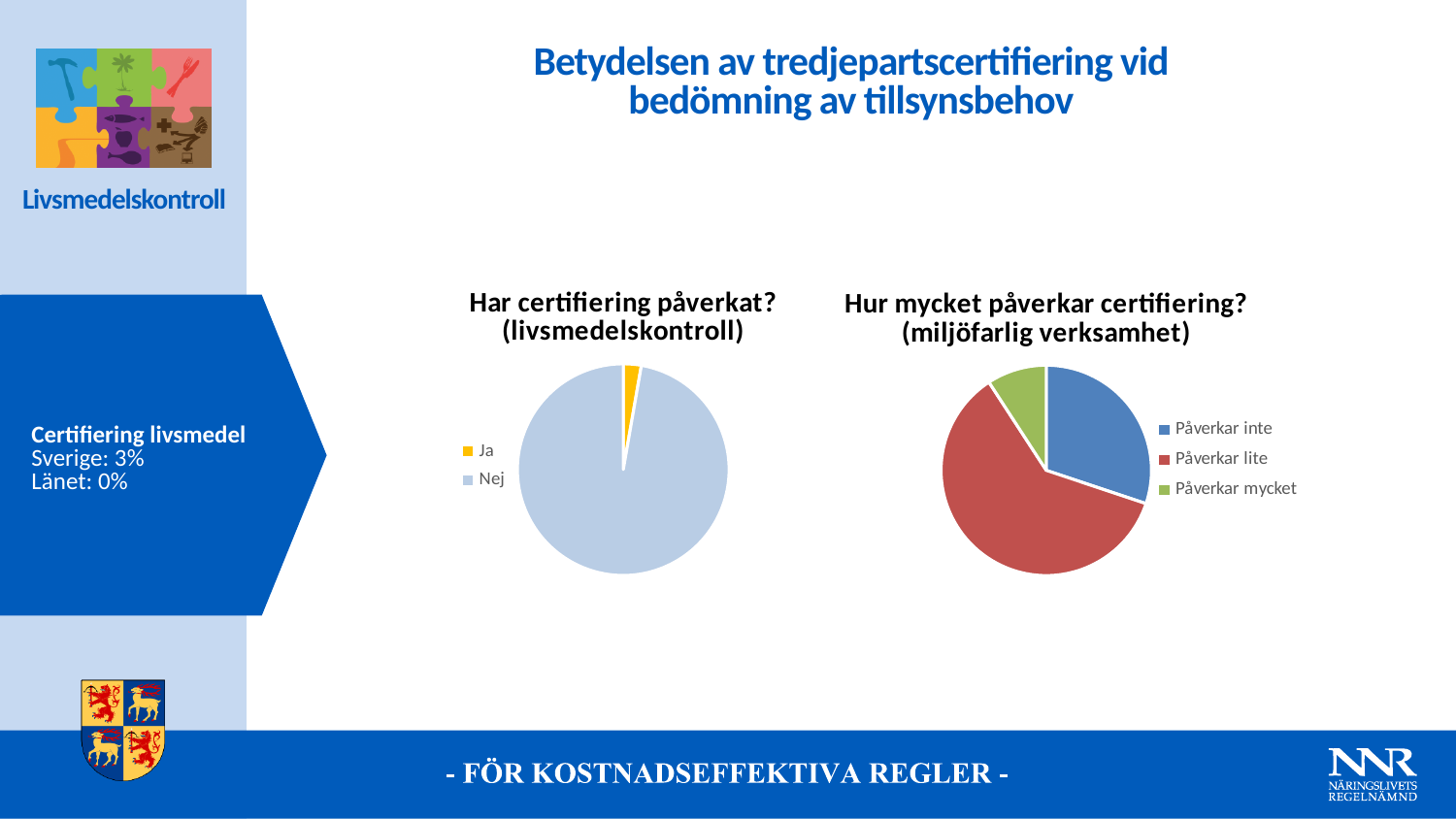
In the chart "Hur mycket påverkar certifiering? (miljöfarlig verksamhet)", which category has the smallest slice? Påverkar mycket In the chart "Har certifiering påverkat? (livsmedelskontroll)", which category has the largest slice? Nej In the chart "Hur mycket påverkar certifiering? (miljöfarlig verksamhet)", what colour is the Påverkar lite slice? Red In the chart "Hur mycket påverkar certifiering? (miljöfarlig verksamhet)", which category has the largest slice? Påverkar lite In the chart "Hur mycket påverkar certifiering? (miljöfarlig verksamhet)", which slice is larger: Påverkar inte or Påverkar mycket? Påverkar inte In the chart "Har certifiering påverkat? (livsmedelskontroll)", which slice is larger: Ja or Nej? Nej In the chart "Hur mycket påverkar certifiering? (miljöfarlig verksamhet)", how many categories does the legend list? 3 What kind of chart is "Har certifiering påverkat? (livsmedelskontroll)"? Pie chart How many pie charts are shown on the slide? 2 What kind of chart is "Hur mycket påverkar certifiering? (miljöfarlig verksamhet)"? Pie chart In the chart "Har certifiering påverkat? (livsmedelskontroll)", which category has the smallest slice? Ja In the chart "Har certifiering påverkat? (livsmedelskontroll)", how many categories does the legend list? 2